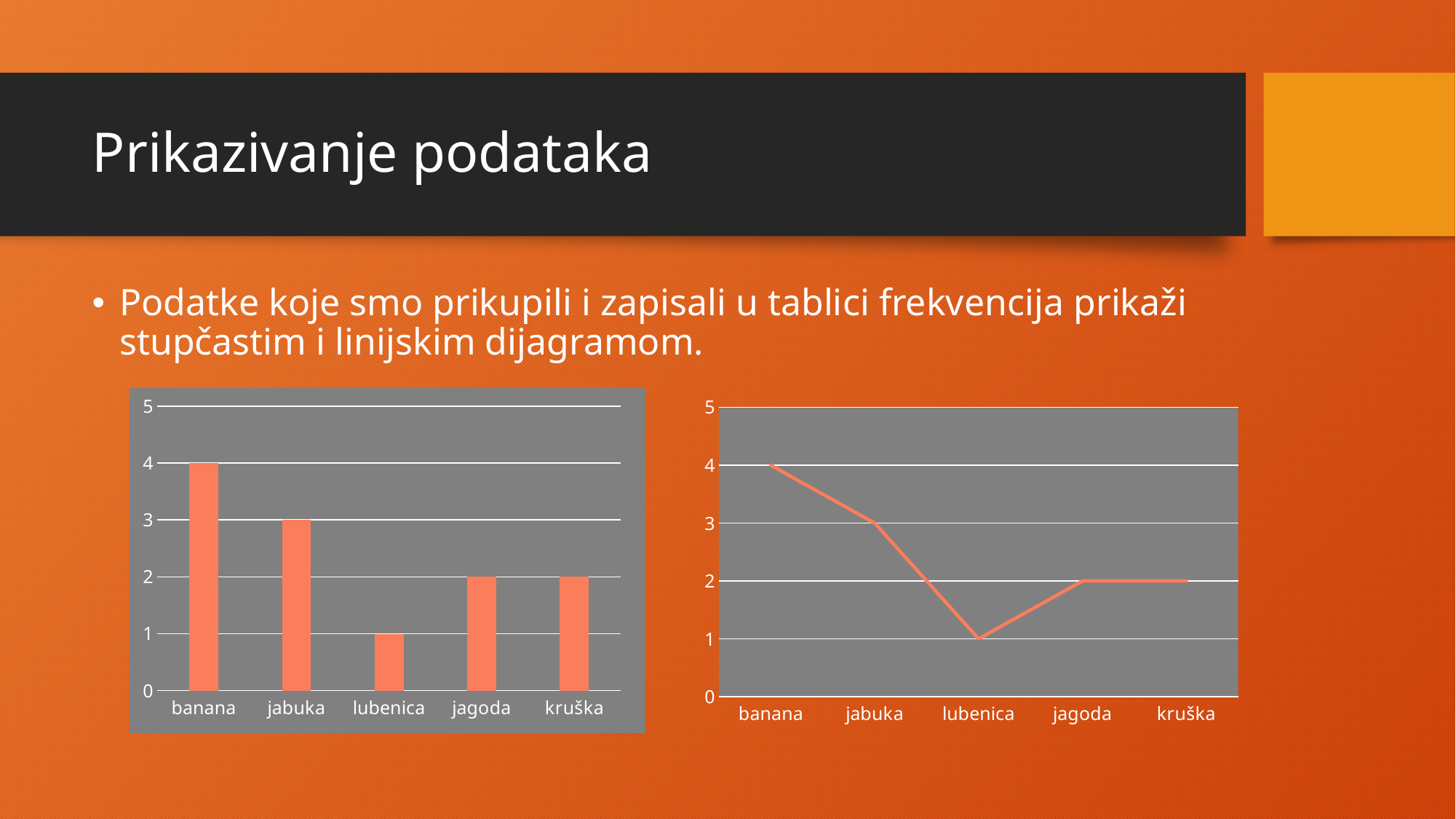
What kind of chart is the chart on the right of the slide? line chart In the line chart on the right, does the value rise or fall from banana to lubenica? fall In the bar chart on the left, what is the value for banana? 4 In the bar chart on the left, what is the difference between the values for banana and jabuka? 1 What kind of chart is the chart on the left of the slide? bar chart In the bar chart on the left, is the value for jabuka greater or less than 2? greater In the line chart on the right, what is the value for jabuka? 3 In the line chart on the right, which is larger, the value for jabuka or the value for jagoda? jabuka In the line chart on the right, which category has the lowest value? lubenica In the bar chart on the left, what is the value for lubenica? 1 How many categories are shown on the x axis of the bar chart on the left? 5 In the bar chart on the left, which category has the highest value? banana